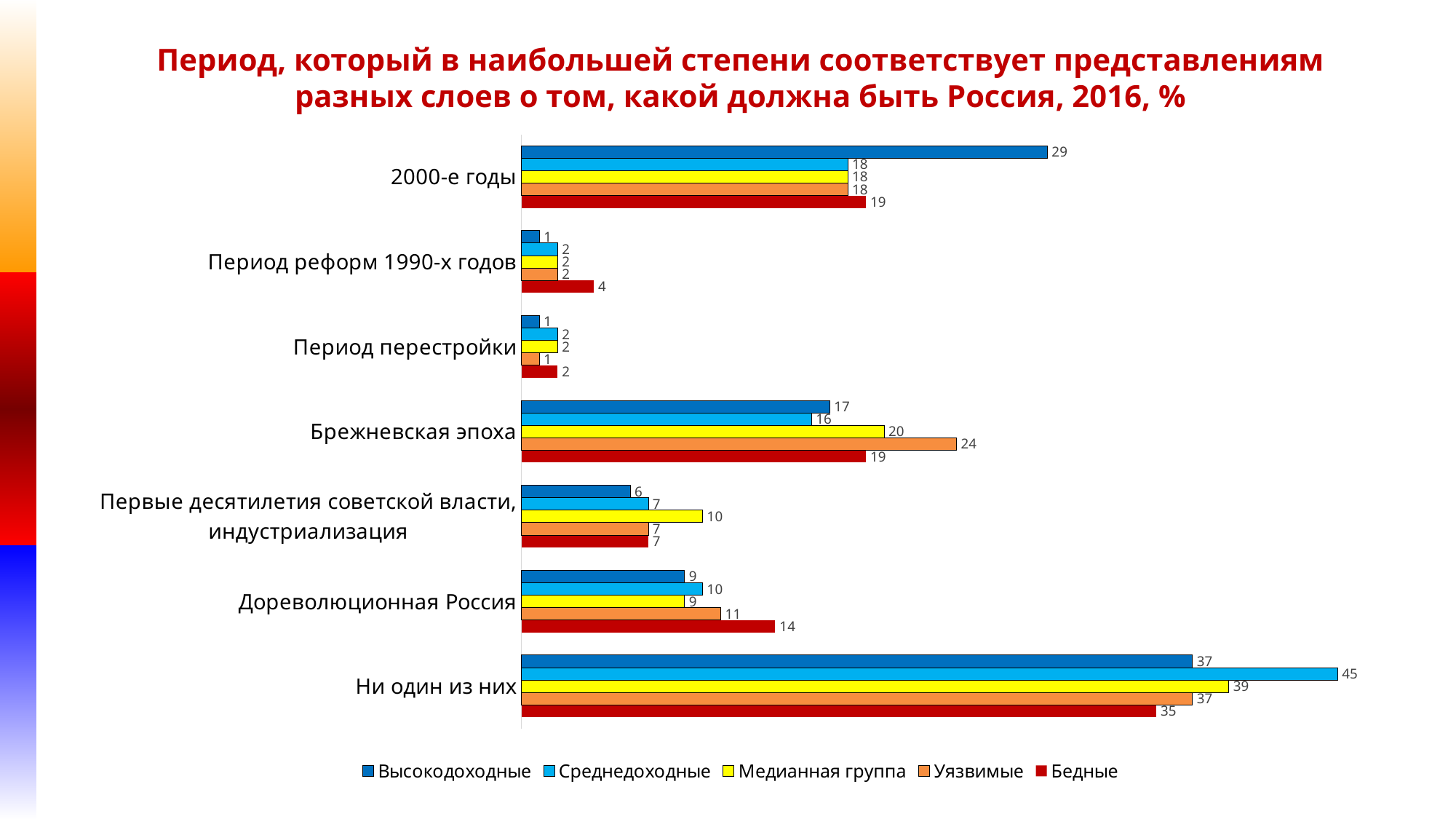
What is the value for Бедные in the category Дореволюционная Россия? 14 Which series is shown in yellow in the legend? Медианная группа What is the difference between the Среднедоходные and Бедные values in the category Ни один из них? 10 What is the value for Среднедоходные in the category Ни один из них? 45 What is the value for Уязвимые in the category Брежневская эпоха? 24 Which series has the lowest value in the category Ни один из них? Бедные Which category has the highest value for the Бедные series? Ни один из них What is the value for Высокодоходные in the category 2000-е годы? 29 What type of chart is shown on the slide? bar chart How many series does the legend list? 5 In the category Брежневская эпоха, which is larger: the value for Медианная группа or the value for Среднедоходные? Медианная группа How many categories (periods) are shown on the chart? 7